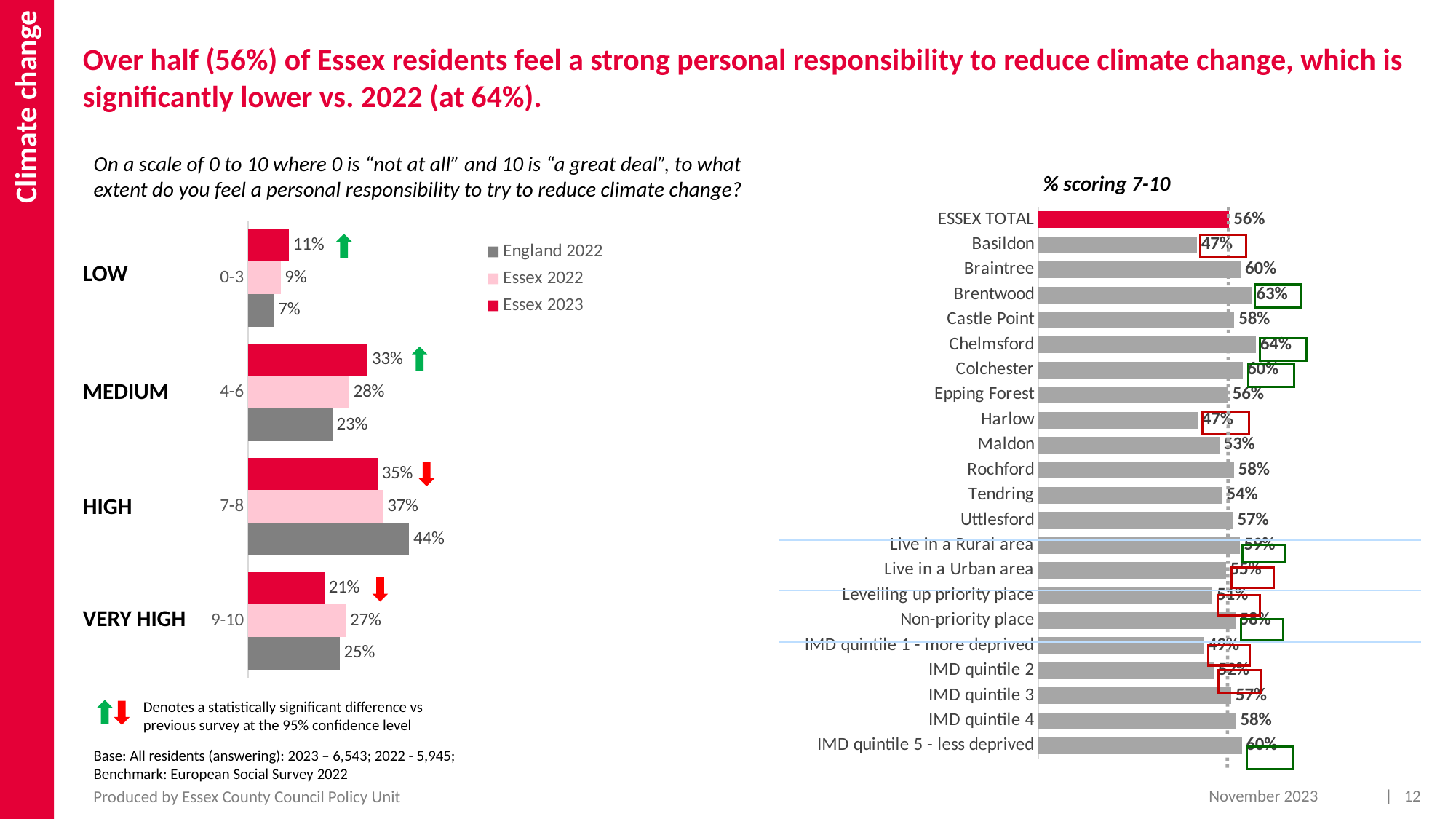
In the '% scoring 7-10' chart, what is the value for ESSEX TOTAL? 56% In the left chart, what is the England 2022 value for the VERY HIGH (9-10) group? 25% In the '% scoring 7-10' chart, which district has the highest value among the districts listed from Basildon to Uttlesford? Chelmsford What type of chart is the '% scoring 7-10' chart on the right? Bar chart In the '% scoring 7-10' chart, what is the value for Chelmsford? 64% How many series does the legend of the left chart list? 3 In the left chart, what is the difference between the England 2022 and Essex 2023 values for the HIGH (7-8) group? 9% In the left chart, what is the Essex 2022 value for the MEDIUM (4-6) group? 28% In the left chart, which is larger for the VERY HIGH (9-10) group: Essex 2022 or Essex 2023? Essex 2022 In the '% scoring 7-10' chart, which is larger: Braintree or Maldon? Braintree In the left chart, what is the Essex 2023 value for the HIGH (7-8) group? 35% In the '% scoring 7-10' chart, what is the difference between Brentwood and Harlow? 16%